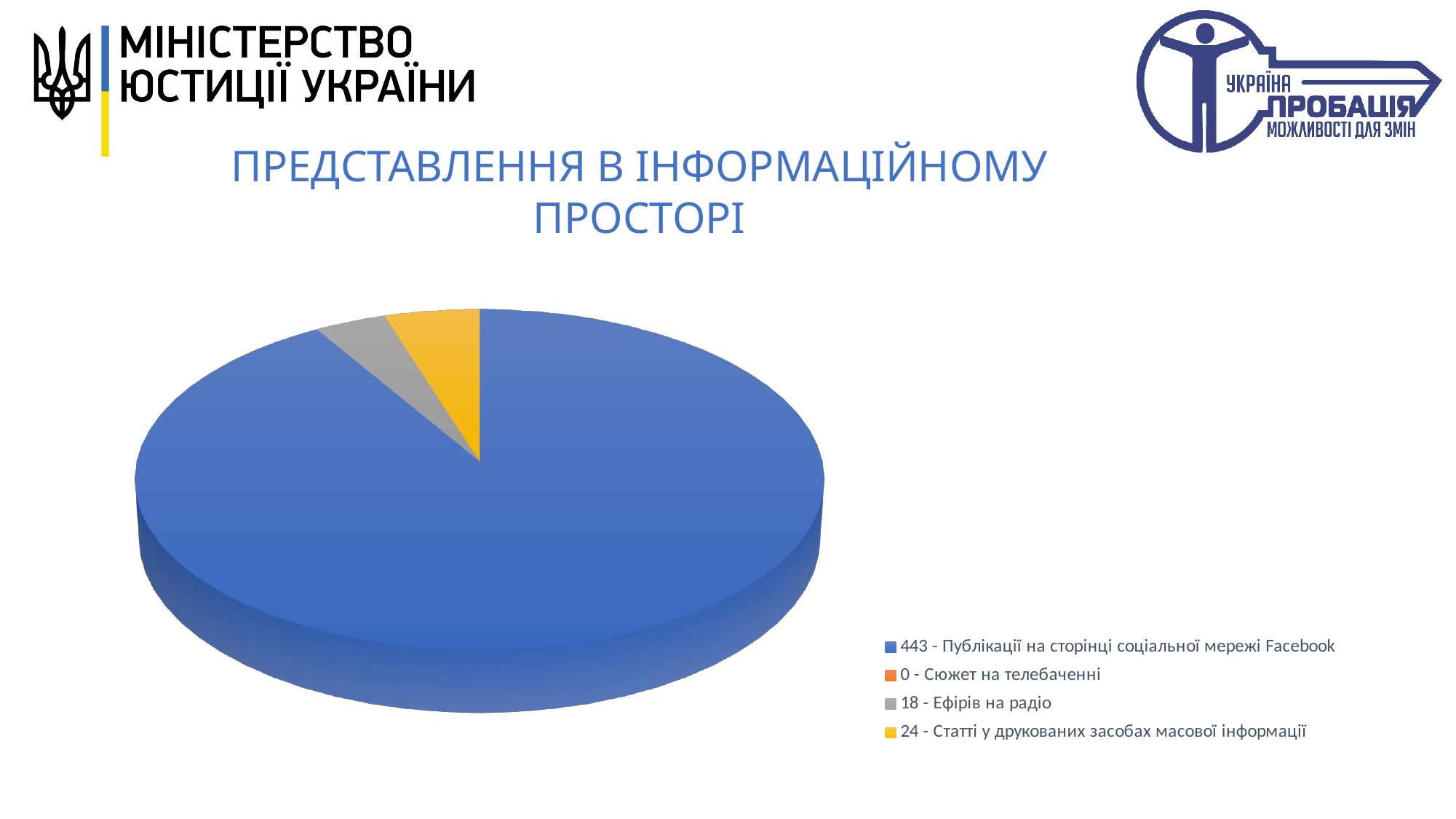
Which is larger: the value for Ефірів на радіо or the value for Статті у друкованих засобах масової інформації? Статті у друкованих засобах масової інформації What is the value for Ефірів на радіо? 18 What is the total of all values shown in the pie chart's legend? 485 How many categories does the pie chart's legend list? 4 What is the value for Статті у друкованих засобах масової інформації? 24 What is the difference between the value for Публікації на сторінці соціальної мережі Facebook and the value for Статті у друкованих засобах масової інформації? 419 Which category has the lowest value in the pie chart? Сюжет на телебаченні Which category has the highest value in the pie chart? Публікації на сторінці соціальної мережі Facebook What is the value for Публікації на сторінці соціальної мережі Facebook? 443 What is the value for Сюжет на телебаченні? 0 What is the title of the slide above the pie chart? ПРЕДСТАВЛЕННЯ В ІНФОРМАЦІЙНОМУ ПРОСТОРІ What kind of chart is shown on the slide? pie chart